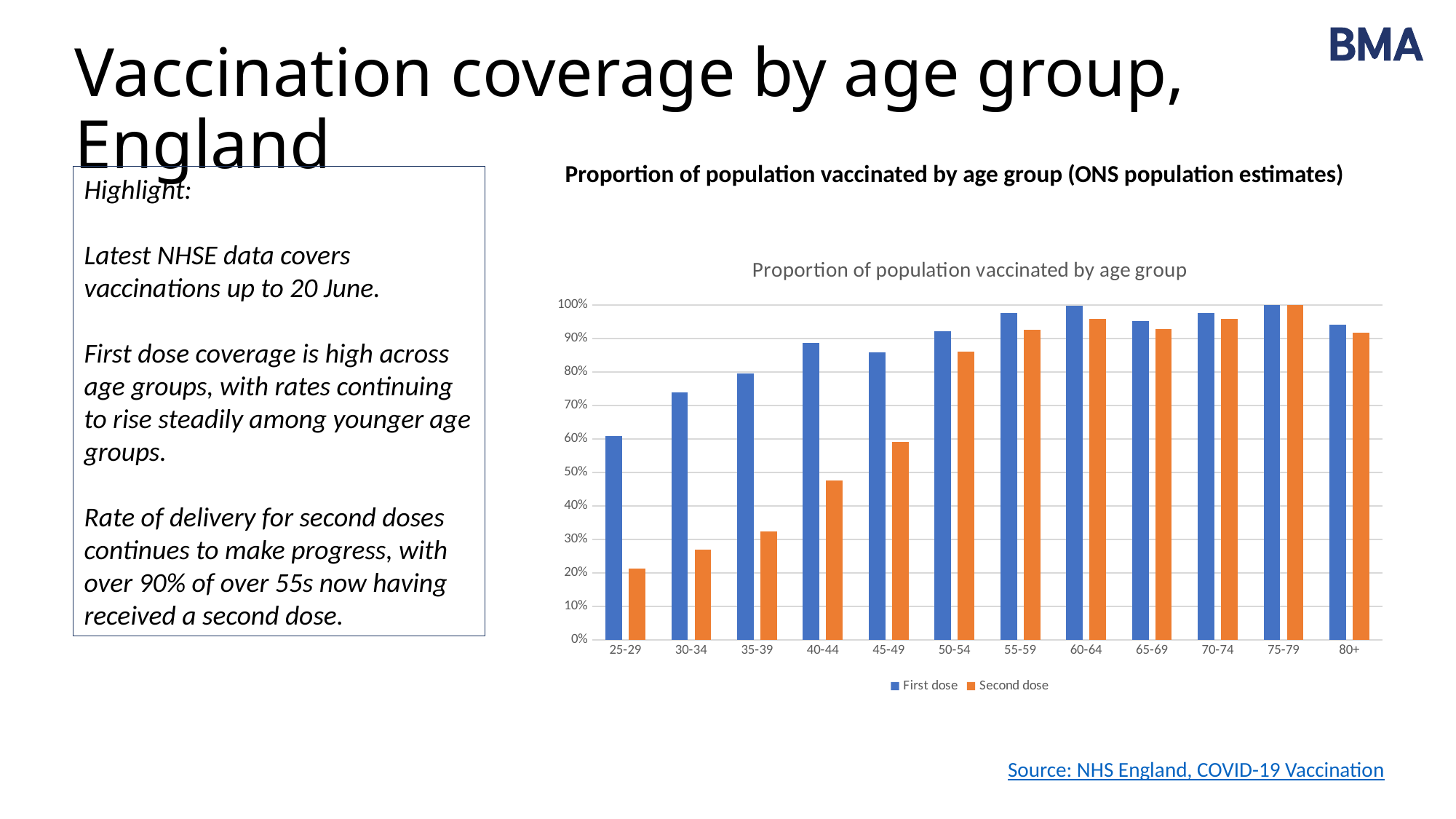
Is the Second dose value for 25-29 greater or less than 30%? less How many series does the chart's legend list? 2 Is the Second dose value for 40-44 greater or less than 50%? less Do the Second dose values rise or fall from 25-29 to 50-54? rise What kind of chart is shown on the slide? Bar chart How many age groups are shown on the x axis of the chart? 12 Is the Second dose value for 45-49 greater or less than 50%? greater For the 35-39 age group, which is larger: First dose or Second dose? First dose What are the two legend entries of the chart? First dose, Second dose Which age group has the lowest First dose value? 25-29 Which age group has the lowest Second dose value? 25-29